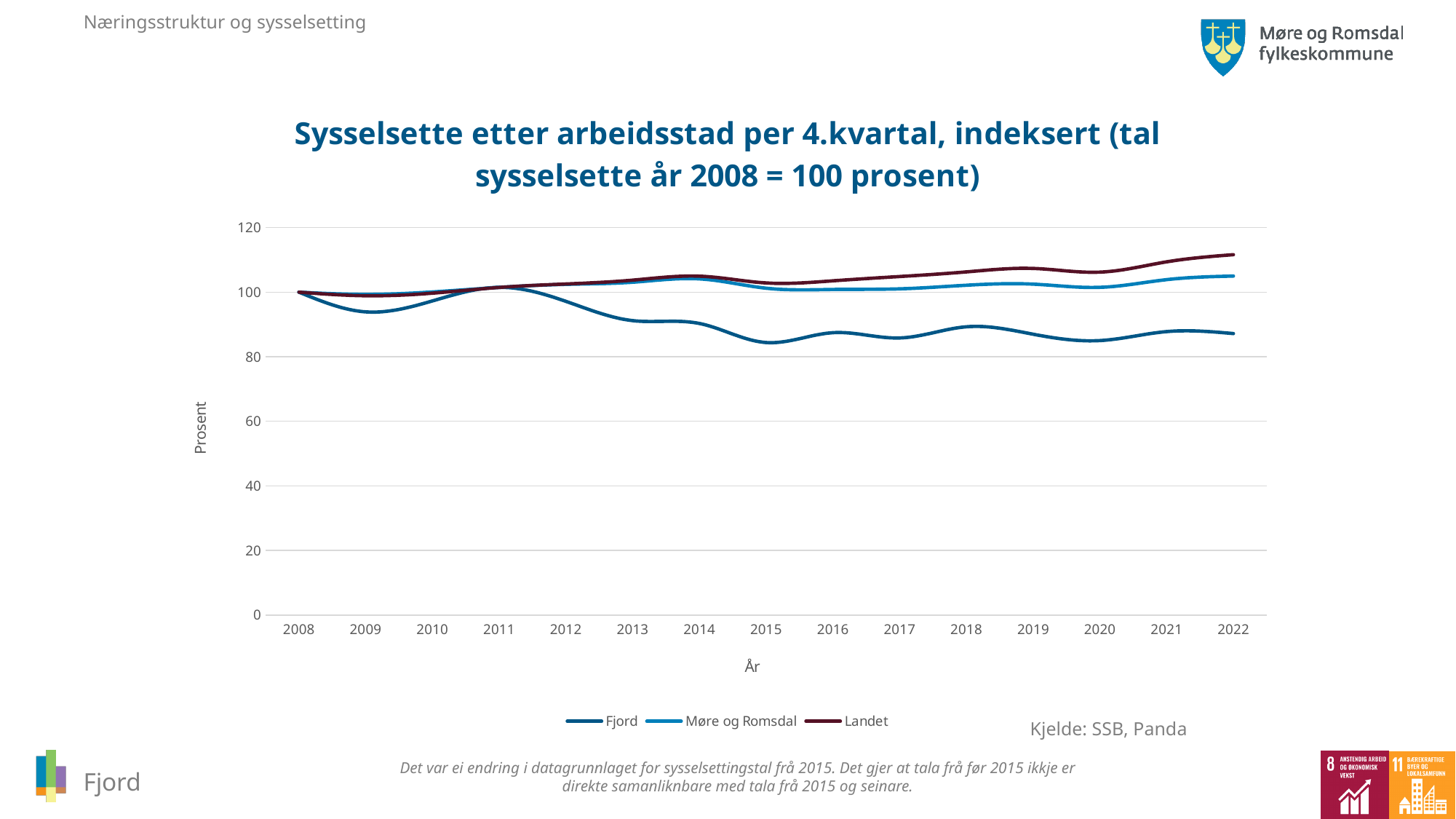
What is the value for Fjord in 2008? 100 Is the value for Landet in 2022 greater or less than 100? greater Does the Fjord line overall rise or fall from 2008 to 2022? fall Which series has the highest value in 2022? Landet In 2022, which is larger: the value for Landet or the value for Fjord? Landet How many years are plotted along the x axis? 15 How many series does the legend list? 3 Is the value for Fjord in 2015 greater or less than 100? less Is the value for Fjord in 2022 greater or less than 100? less What kind of chart is shown on the slide? line chart What is the label on the y axis? Prosent Which series has the lowest value in 2022? Fjord